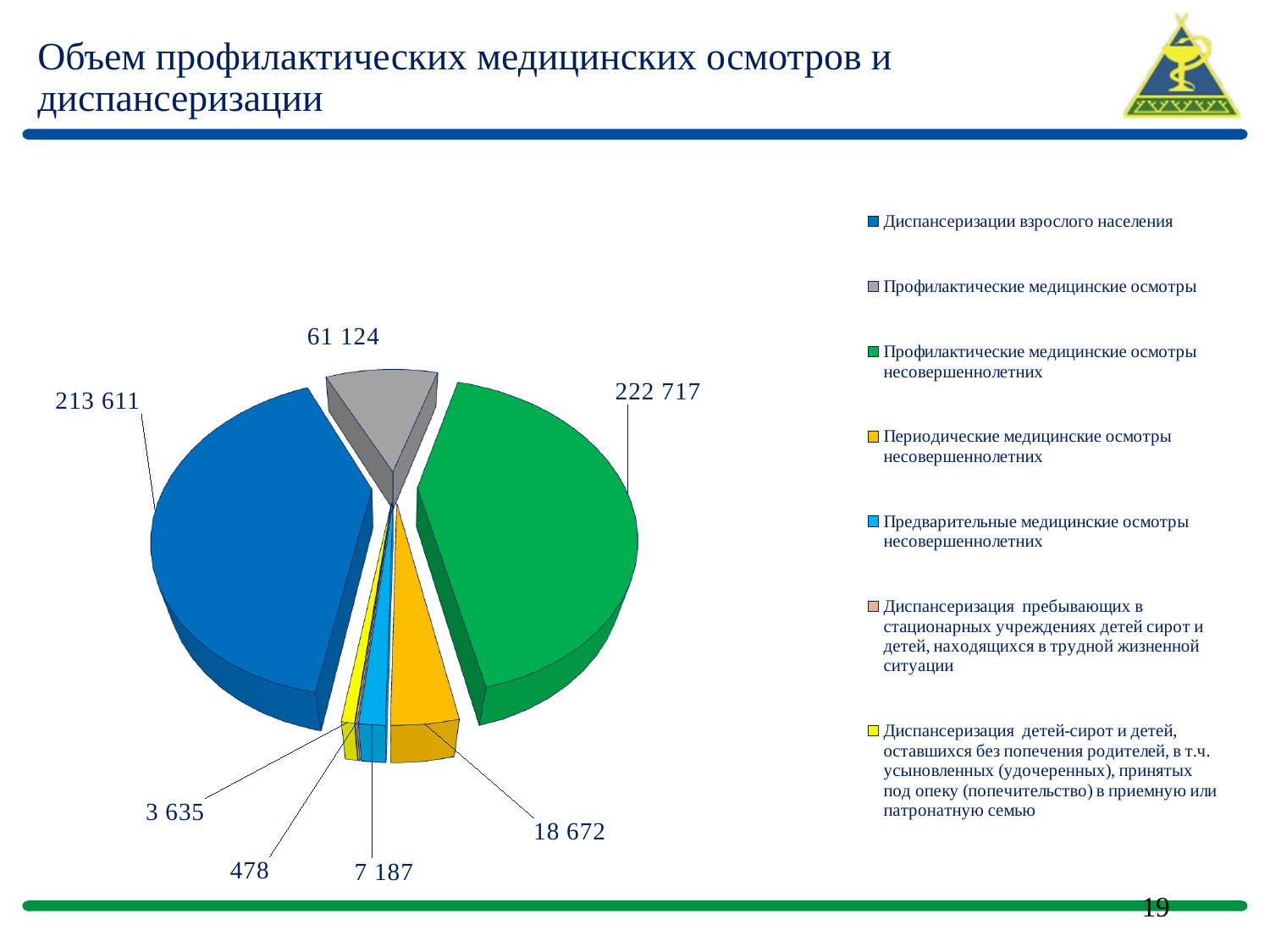
What type of chart is shown on the slide? pie chart What is the value for Предварительные медицинские осмотры несовершеннолетних? 7 187 What is the value for Периодические медицинские осмотры несовершеннолетних? 18 672 What is the value for Диспансеризации взрослого населения? 213 611 Which category has the smallest slice of the pie? Диспансеризация пребывающих в стационарных учреждениях детей сирот и детей, находящихся в трудной жизненной ситуации What is the value for Профилактические медицинские осмотры? 61 124 Which is larger: the value for Профилактические медицинские осмотры or the value for Периодические медицинские осмотры несовершеннолетних? Профилактические медицинские осмотры What colour is the slice for Диспансеризации взрослого населения? blue How many slices does the pie chart have? 7 What is the value for Профилактические медицинские осмотры несовершеннолетних? 222 717 What is the difference between the values for Профилактические медицинские осмотры несовершеннолетних and Диспансеризации взрослого населения? 9 106 Which category has the largest slice of the pie? Профилактические медицинские осмотры несовершеннолетних